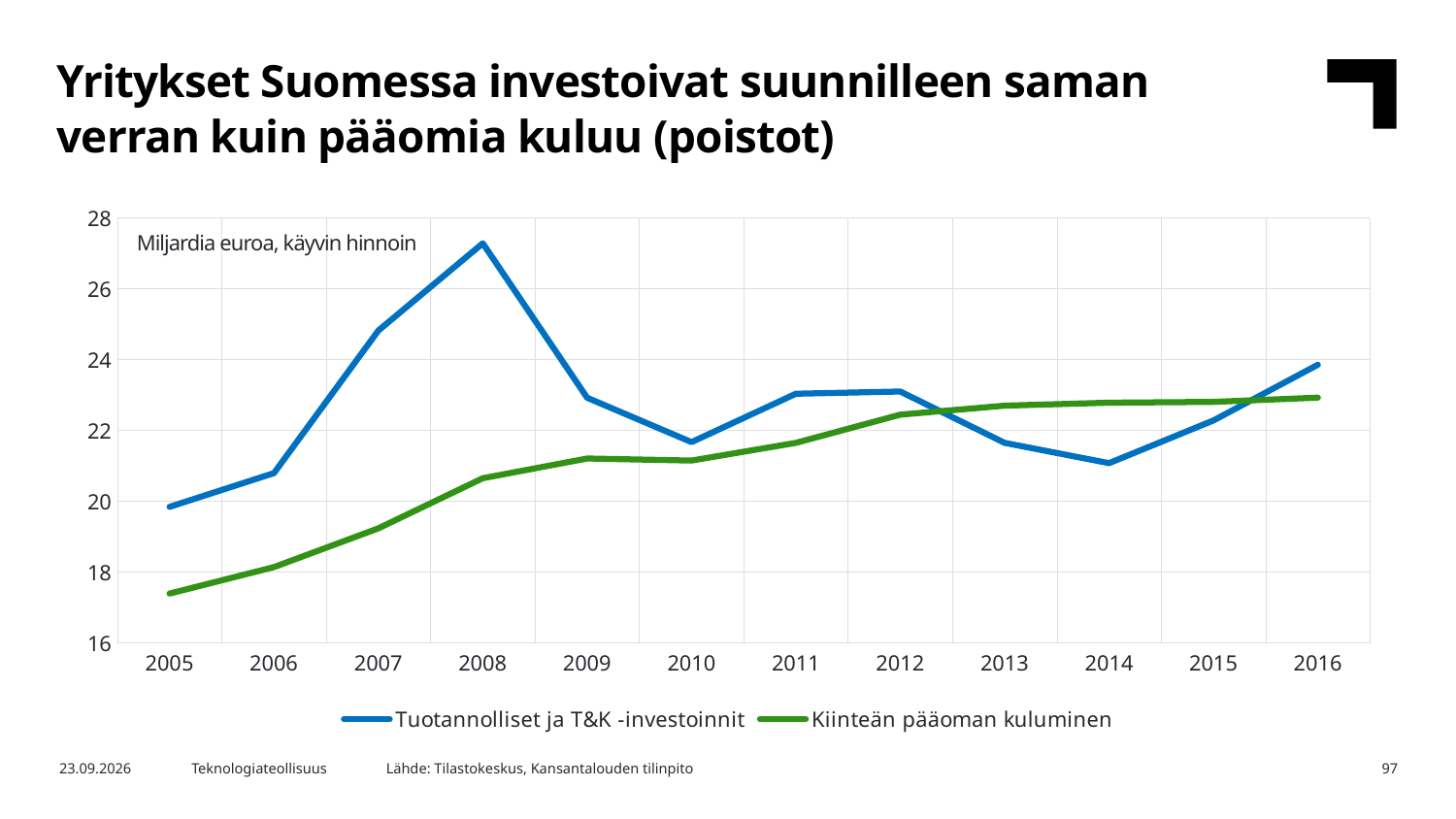
In which year is the Kiinteän pääoman kuluminen series at its lowest? 2005 What unit label is shown inside the chart area? Miljardia euroa, käyvin hinnoin How many series does the legend list? 2 How many years are shown on the x axis? 12 What kind of chart is shown on the slide? line chart Is the value for Kiinteän pääoman kuluminen in 2005 greater or less than 18? less Does the Kiinteän pääoman kuluminen series generally rise or fall from 2005 to 2016? rise Is the value for Tuotannolliset ja T&K -investoinnit in 2008 greater or less than 26? greater In 2014, which series has the higher value: Tuotannolliset ja T&K -investoinnit or Kiinteän pääoman kuluminen? Kiinteän pääoman kuluminen In which year is the Tuotannolliset ja T&K -investoinnit series at its lowest? 2005 What colour is the line for Kiinteän pääoman kuluminen? green In which year does the Tuotannolliset ja T&K -investoinnit series reach its highest value? 2008